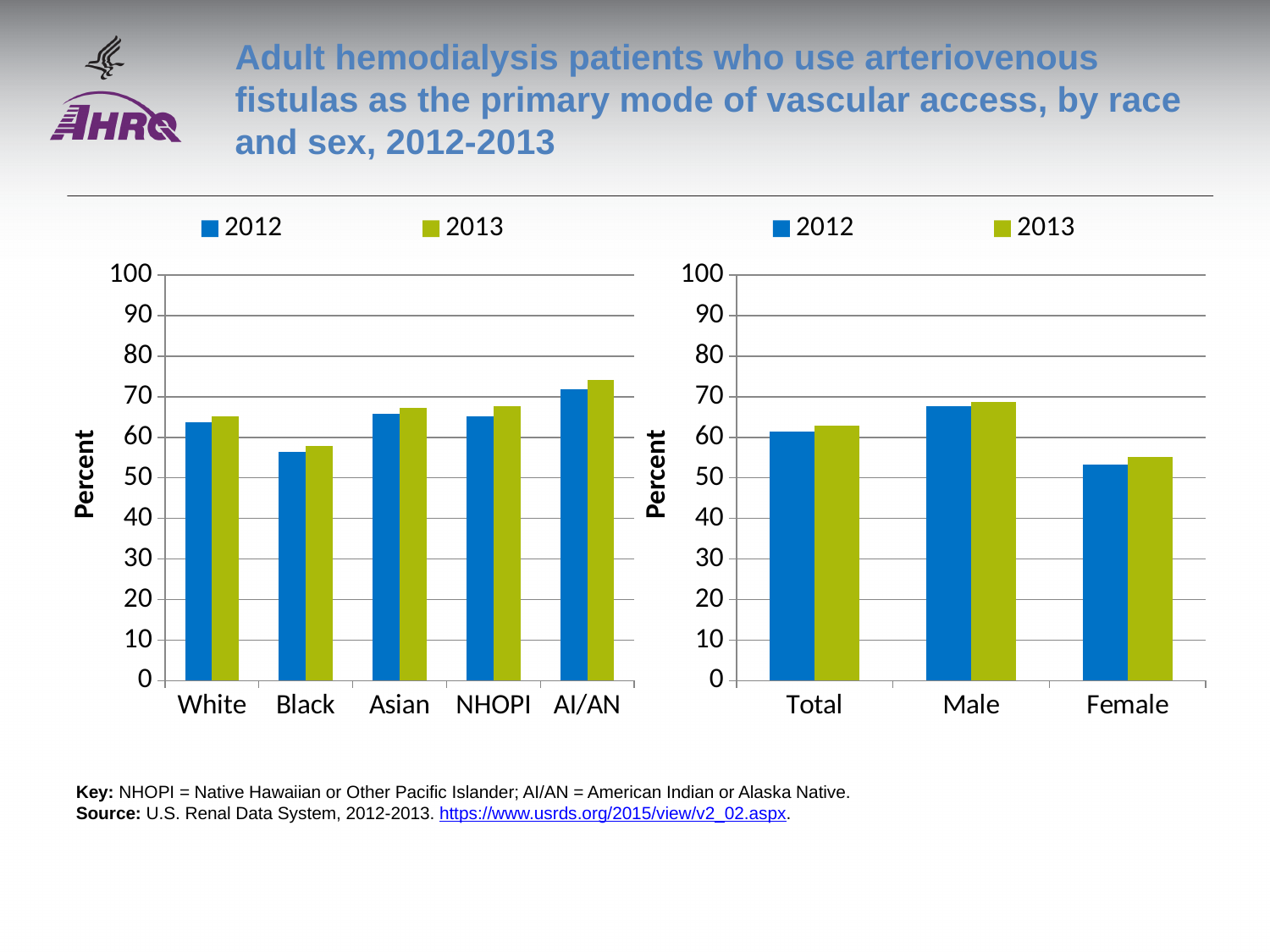
In the left chart (by race), how many race categories are shown on the x axis? 5 In the right chart (by sex), which is larger for 2013: Male or Female? Male In the left chart (by race), is the 2013 value for AI/AN greater or less than 70? greater In the left chart (by race), which race has the lowest value for 2012? Black In the left chart (by race), which is larger for 2012: White or Black? White In the left chart (by race), which race has the highest value for 2013? AI/AN In the left chart (by race), how many series does the legend list? 2 In the left chart (by race), is the 2012 value for Black greater or less than 60? less In the right chart (by sex), what is the label on the y axis? Percent In the left chart (by race), what kind of chart is shown? bar chart In the right chart (by sex), how many categories are shown on the x axis? 3 In the right chart (by sex), is the 2013 value for Female greater or less than 60? less